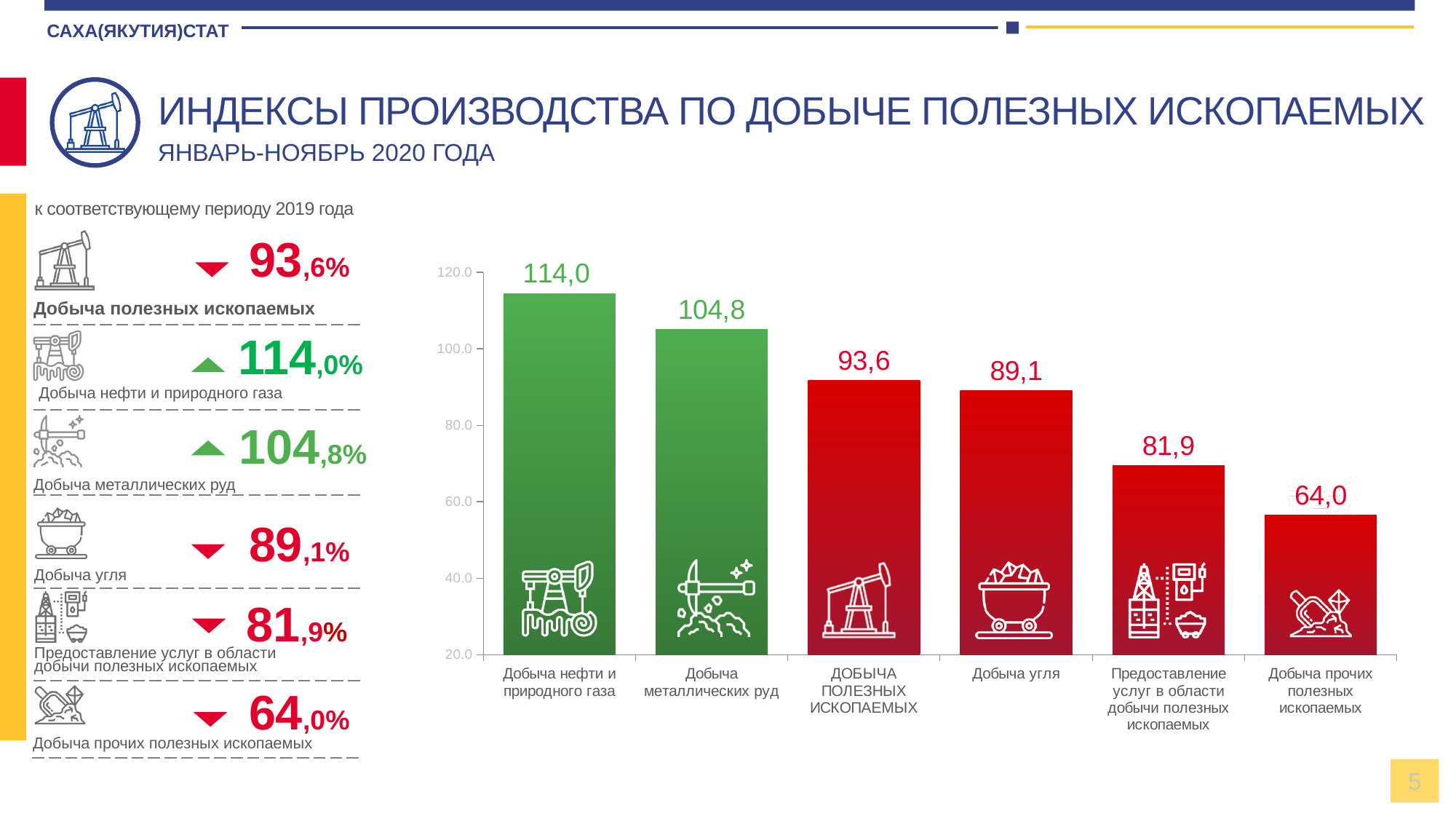
How many categories are shown in the chart? 6 Do the values rise or fall from left to right along the x axis? Fall What kind of chart is shown on the slide? Bar chart What is the value for Предоставление услуг в области добычи полезных ископаемых? 81,9 Which category has the lowest value? Добыча прочих полезных ископаемых Which category has the highest value? Добыча нефти и природного газа What is the value for Добыча нефти и природного газа? 114,0 What is the value for Добыча угля? 89,1 What is the difference between the values for Добыча нефти и природного газа and Добыча прочих полезных ископаемых? 50,0 Which is larger, the value for Добыча угля or the value for Предоставление услуг в области добычи полезных ископаемых? Добыча угля What is the value for Добыча металлических руд? 104,8 What is the difference between the values for Добыча металлических руд and ДОБЫЧА ПОЛЕЗНЫХ ИСКОПАЕМЫХ? 11,2